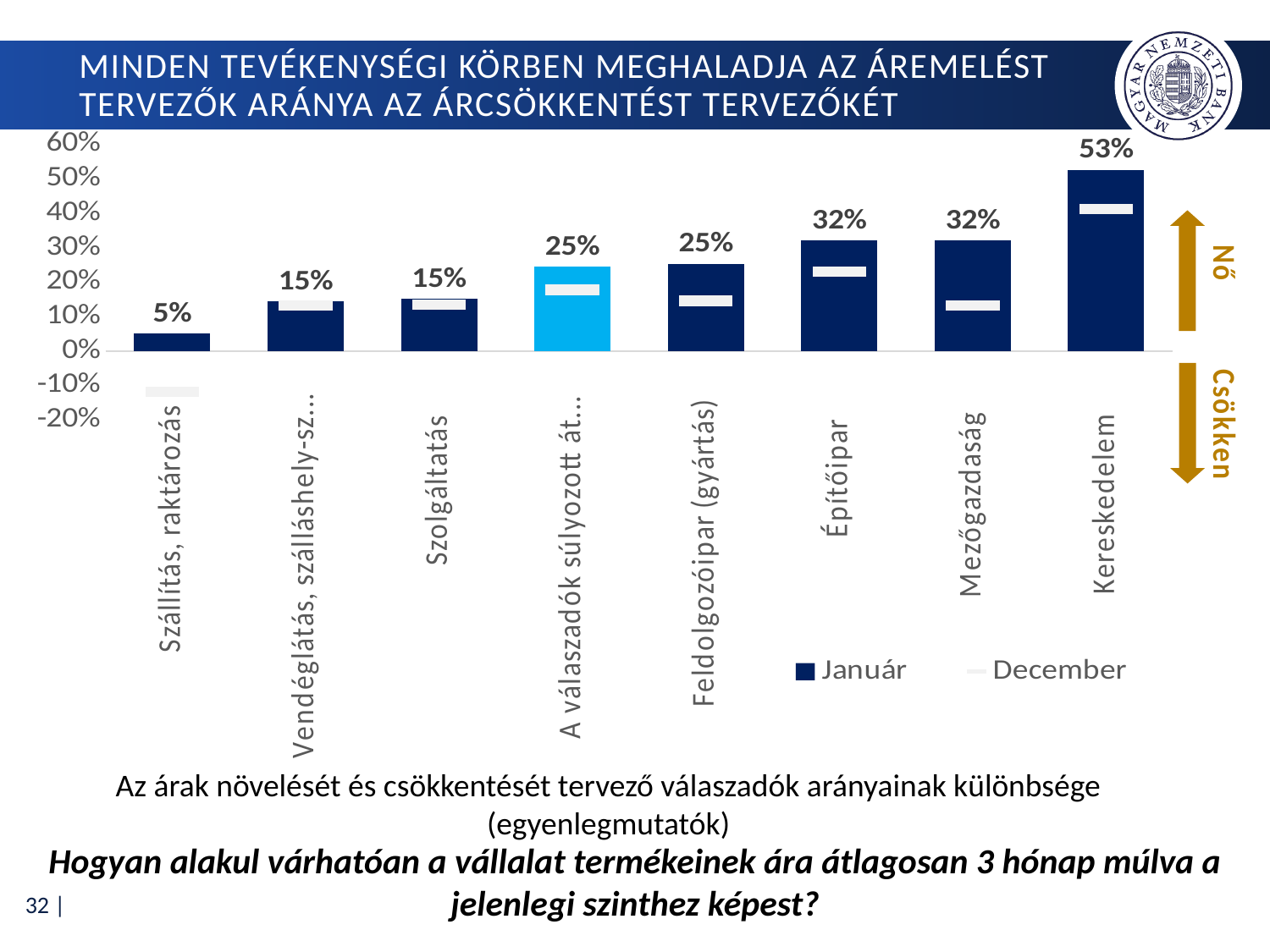
What is the January value for Feldolgozóipar (gyártás)? 25% Which category has the lowest January value? Szállítás, raktározás How many categories are shown on the x axis? 8 Is the December value for Szállítás, raktározás greater or less than 0%? less Do the January values rise or fall from left to right along the x axis? rise Which category has the highest January value? Kereskedelem What is the January value for Szállítás, raktározás? 5% Which has a larger January value, Szolgáltatás or Építőipar? Építőipar How many series does the legend list? 2 What is the January value for Építőipar? 32% What is the January value for Kereskedelem? 53% What is the difference between the January values for Kereskedelem and Mezőgazdaság? 21%